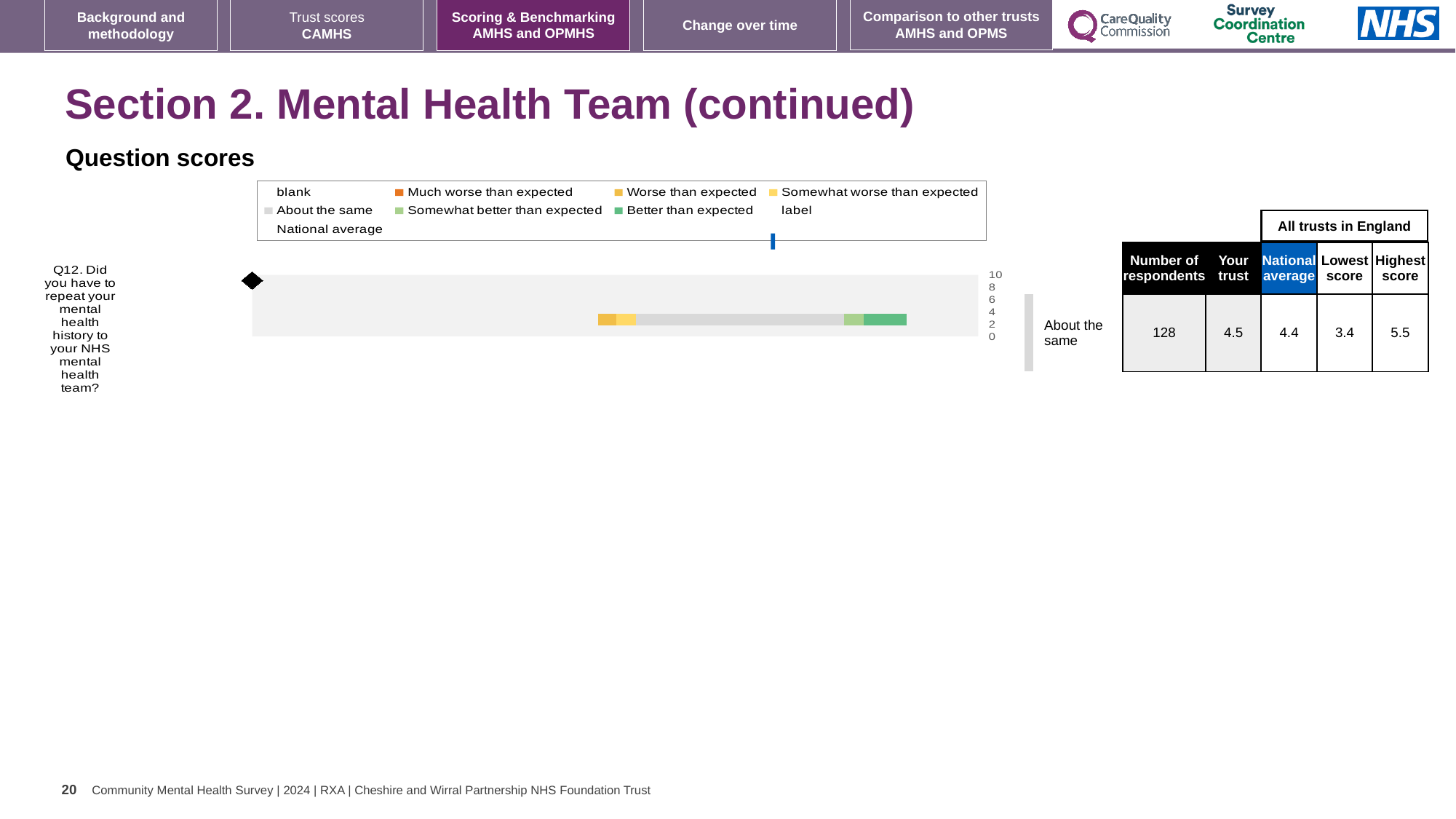
Which is higher for Q12, the trust's score or the national average? Your trust By how much does the trust's score for Q12 exceed the national average? 0.1 How many respondents answered Q12? 128 What kind of chart is used to show the Q12 question score? Bar chart Which benchmark category is shown next to the Q12 bar? About the same What is the difference between the highest and lowest scores for Q12? 2.1 What is the 'Your trust' score for Q12? 4.5 How many questions are plotted on the chart? 1 What is the national average score for Q12? 4.4 Which legend entry is shown in orange? Much worse than expected What is the lowest score among all trusts in England for Q12? 3.4 What is the highest score among all trusts in England for Q12? 5.5